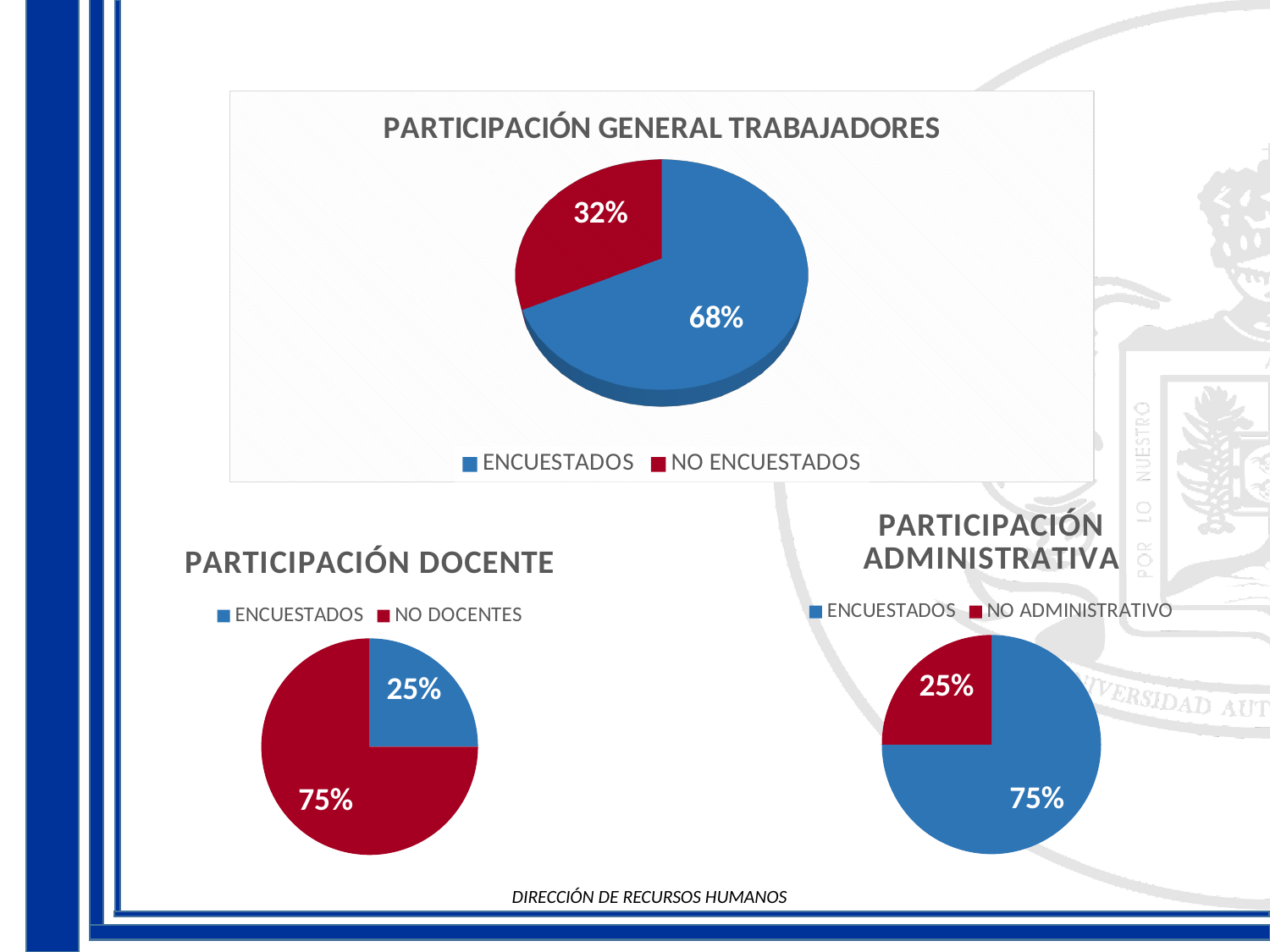
In the PARTICIPACIÓN GENERAL TRABAJADORES chart, what share of the pie is ENCUESTADOS? 68% In the PARTICIPACIÓN ADMINISTRATIVA chart, what share of the pie is NO ADMINISTRATIVO? 25% In the PARTICIPACIÓN ADMINISTRATIVA chart, what share of the pie is ENCUESTADOS? 75% In the PARTICIPACIÓN GENERAL TRABAJADORES chart, what is the difference between the ENCUESTADOS and NO ENCUESTADOS shares? 36% How many entries does the legend of the PARTICIPACIÓN DOCENTE chart list? 2 In the PARTICIPACIÓN DOCENTE chart, which slice is the largest? NO DOCENTES What kind of chart is the PARTICIPACIÓN GENERAL TRABAJADORES chart? Pie chart In the PARTICIPACIÓN GENERAL TRABAJADORES chart, which slice is larger, ENCUESTADOS or NO ENCUESTADOS? ENCUESTADOS In the PARTICIPACIÓN ADMINISTRATIVA chart, which slice is the smallest? NO ADMINISTRATIVO